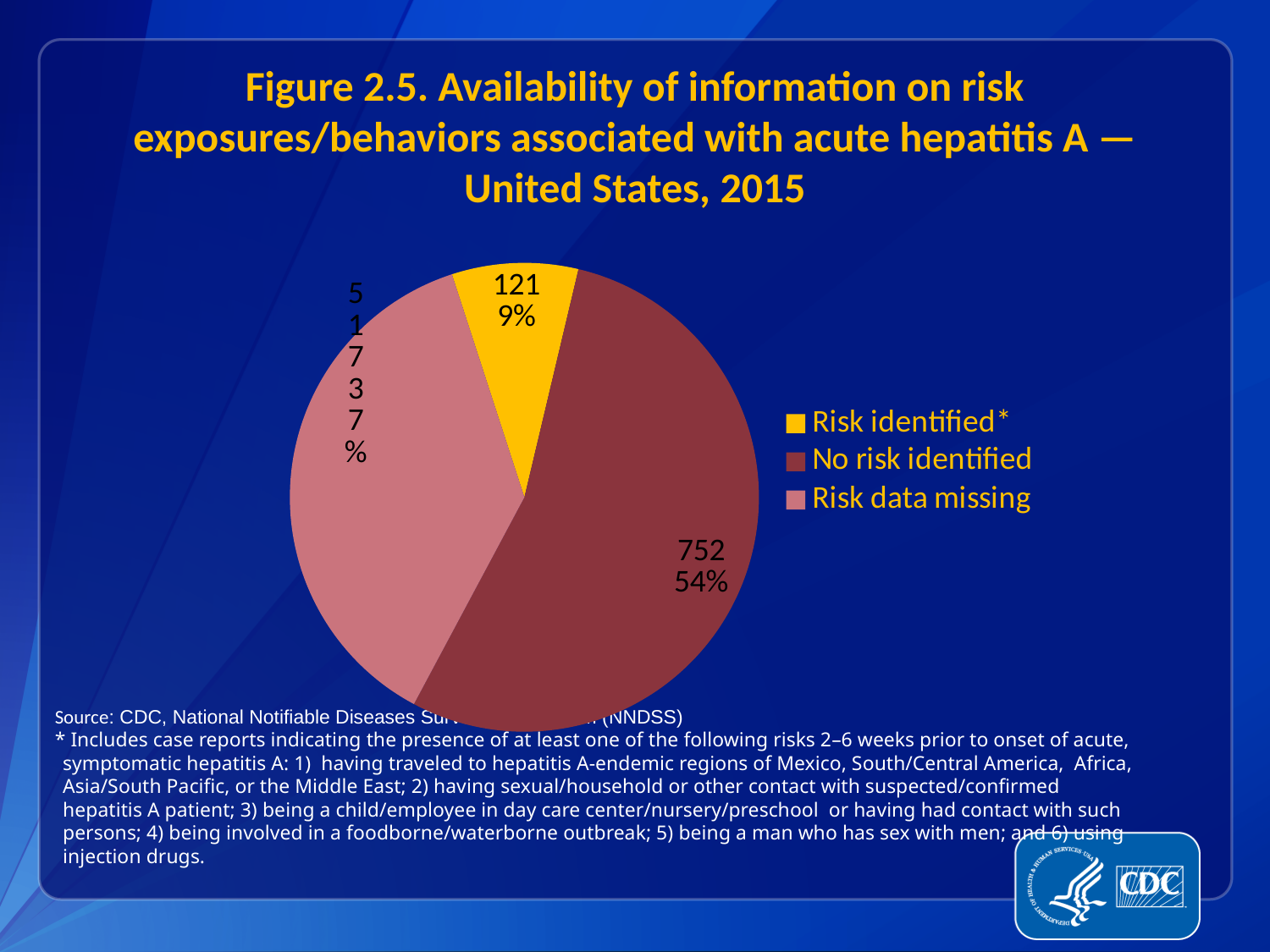
How many cases are in the 'No risk identified' slice? 752 Which category has the smallest slice of the pie? Risk identified* How many slices does the pie chart have? 3 How many entries does the legend list? 3 What colour is the 'Risk identified*' slice? Yellow Which category has the largest slice of the pie? No risk identified Which is larger, the 'Risk data missing' slice or the 'Risk identified*' slice? Risk data missing What percentage of the pie is the 'Risk identified*' slice? 9% What kind of chart is shown on the slide? Pie chart What is the difference between the number of cases with no risk identified and the number with a risk identified? 631 How many cases are in the 'Risk data missing' slice? 517 How many cases are in the 'Risk identified*' slice? 121